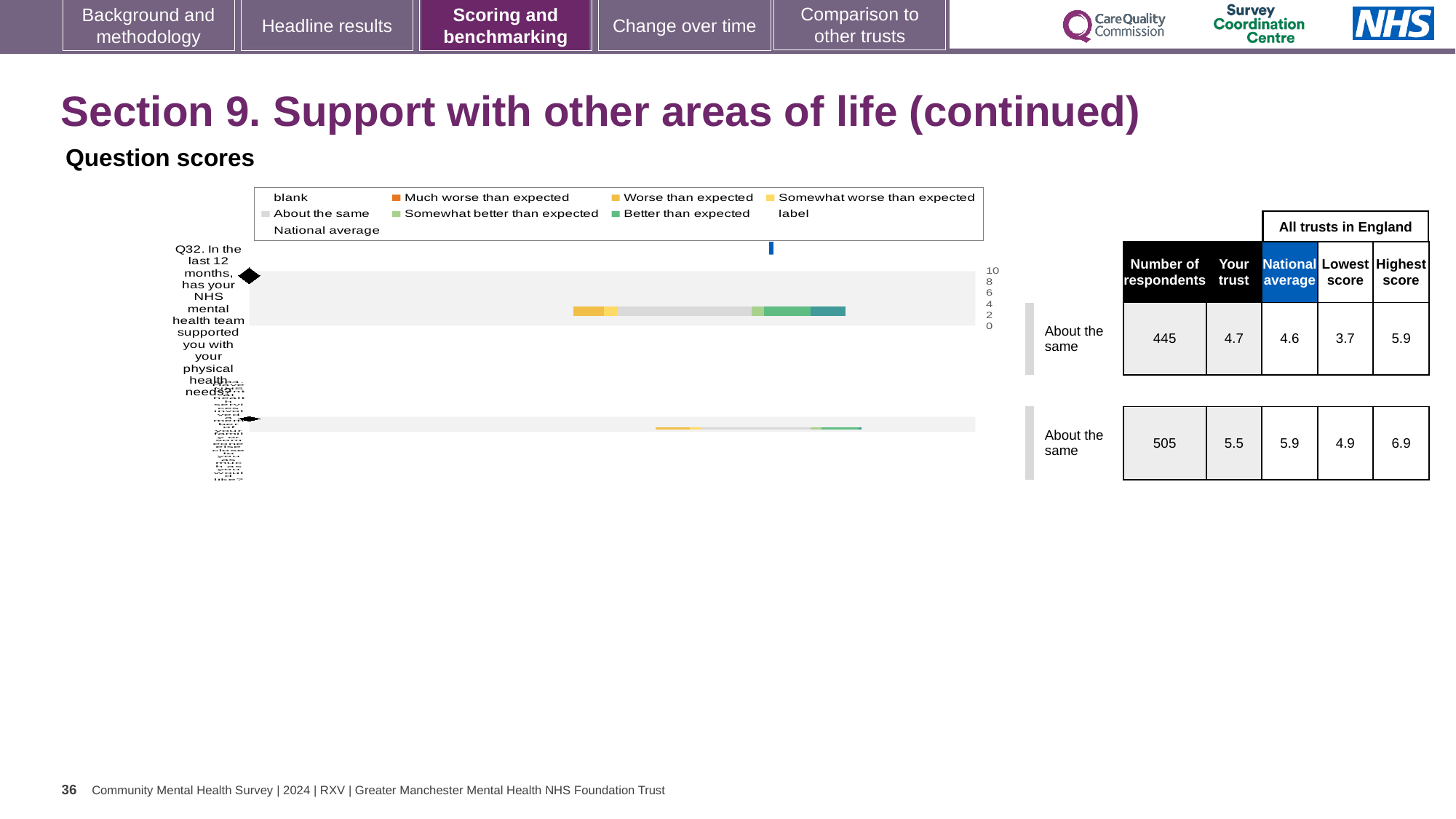
In the table next to the chart, what is the number of respondents for Q32 (support with physical health needs)? 445 What is the 'Your trust' score for Q32 (support with physical health needs)? 4.7 What is the highest score among all trusts in England for Q32? 5.9 What kind of chart is used to show the question scores on this slide? Bar chart What benchmark category is shown for Q32 in the chart? About the same For the second question row in the chart, which is larger: the 'Your trust' score or the national average? National average For Q32, which is larger: the 'Your trust' score or the national average? Your trust How many questions (bars) are plotted in the question scores chart? 2 What is the national average score for Q32 (support with physical health needs)? 4.6 In the chart legend, which category is shown in orange? Much worse than expected For Q32, what is the difference between the highest score and the lowest score among all trusts in England? 2.2 What is the lowest score among all trusts in England for Q32? 3.7